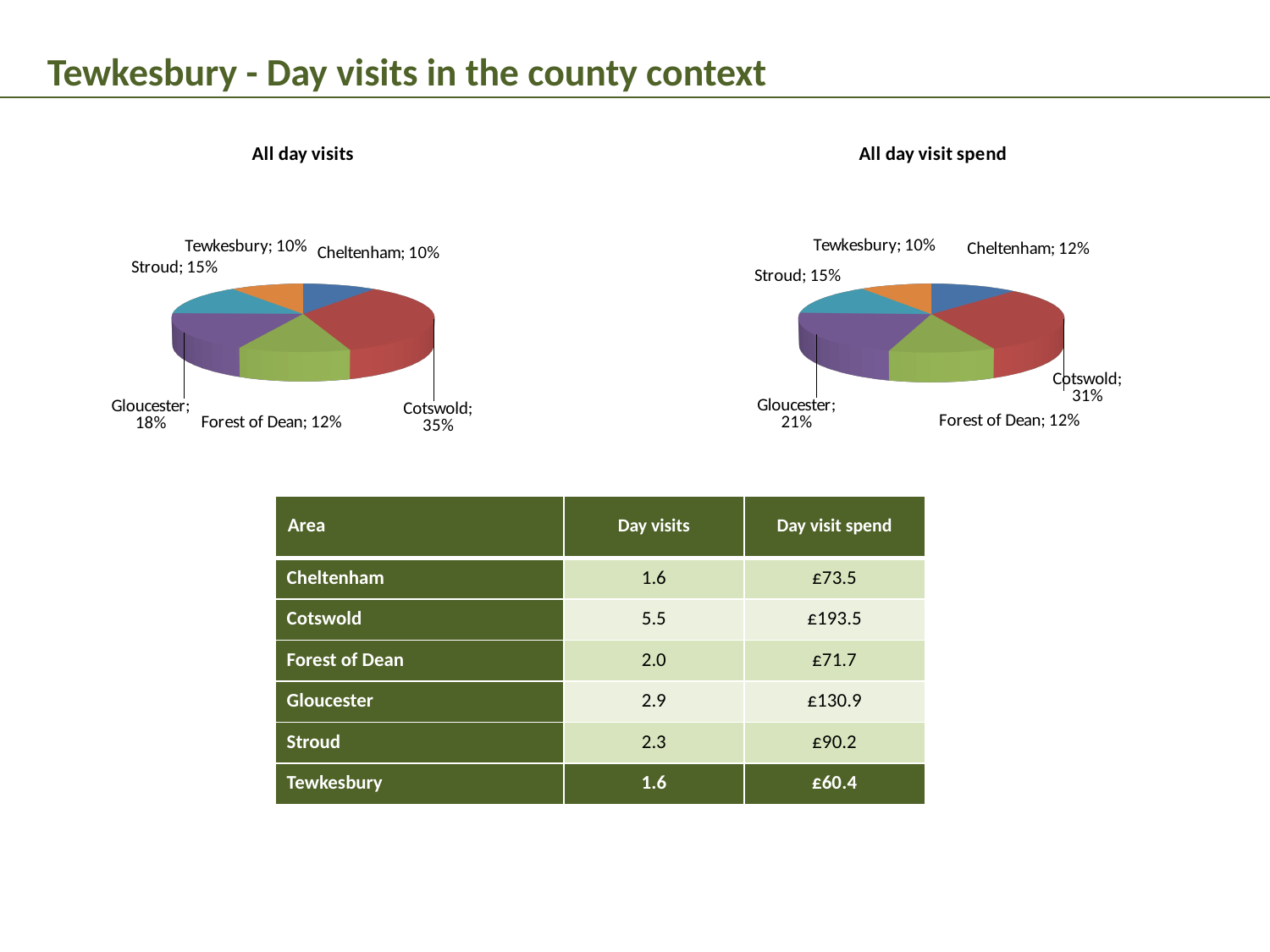
In the 'All day visit spend' chart, which is larger, the Cheltenham share or the Stroud share? Stroud How many areas are shown in the 'All day visits' chart? 6 In the 'All day visit spend' chart, what share does Gloucester have? 21% In the 'All day visits' chart, what share does Forest of Dean have? 12% In the 'All day visits' chart, what share does Cotswold have? 35% In the 'All day visit spend' chart, what is the difference between the Cotswold share and the Forest of Dean share? 19% What is the title of the chart on the left of the slide? All day visits In the 'All day visits' chart, which area has the largest slice? Cotswold In the 'All day visit spend' chart, what share does Cheltenham have? 12% What kind of chart is the 'All day visit spend' chart? Pie chart In the 'All day visits' chart, what is the difference between the Cotswold share and the Gloucester share? 17% In the 'All day visit spend' chart, which area has the smallest slice? Tewkesbury